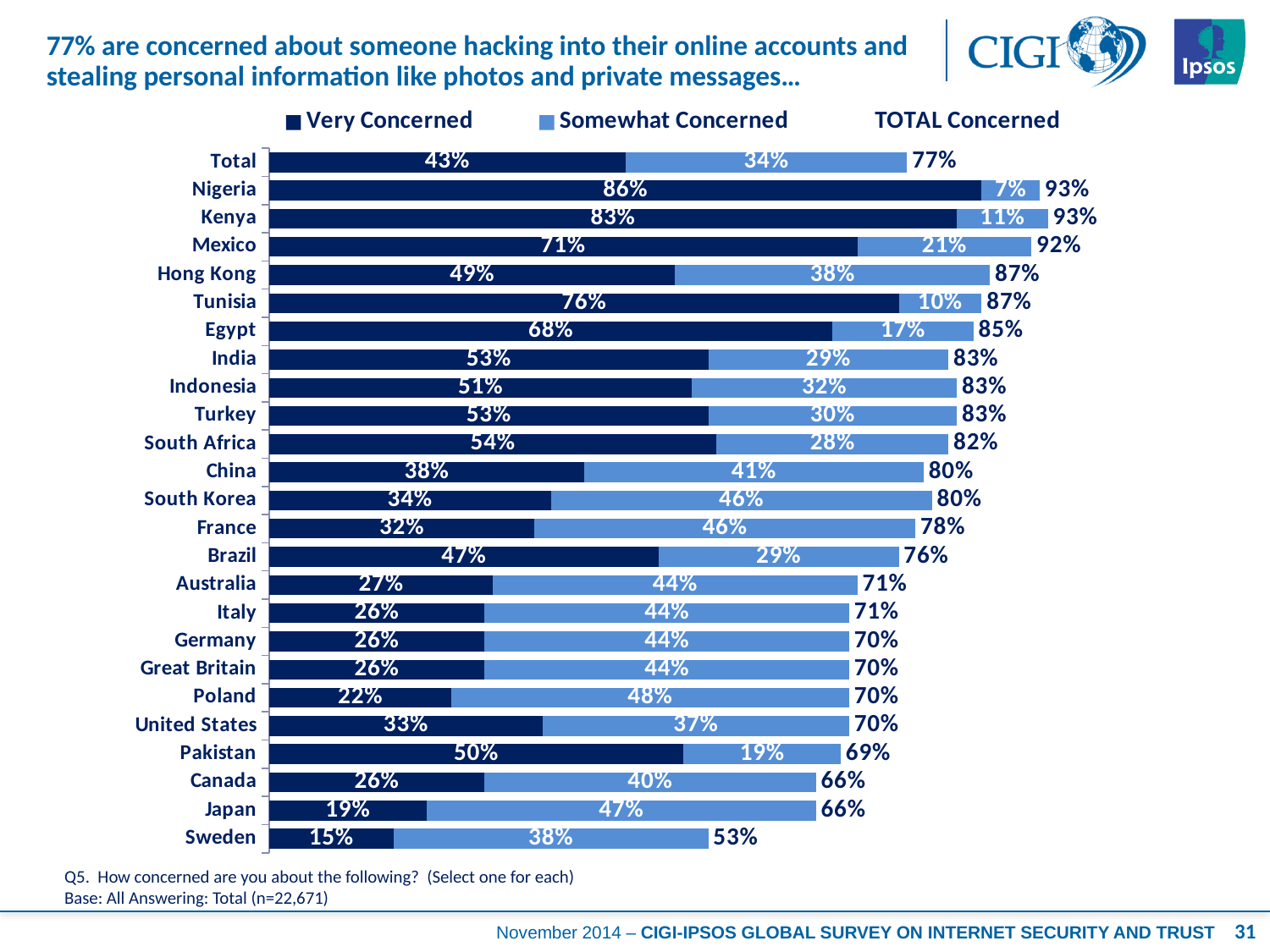
What is the difference between the Very Concerned values for Kenya and Japan? 64% What is the total of the stacked bar for Mexico? 92% What is the TOTAL Concerned value for Sweden? 53% What is the Very Concerned value for Nigeria? 86% Which country has the highest Very Concerned value? Nigeria What kind of chart is shown on the slide? Stacked bar chart How many countries (excluding Total) are shown in the chart? 24 Which series is shown in dark blue in the legend? Very Concerned What is the Somewhat Concerned value for South Korea? 46% Which is larger, the Somewhat Concerned value for China or for Pakistan? China Which category has the lowest TOTAL Concerned value? Sweden